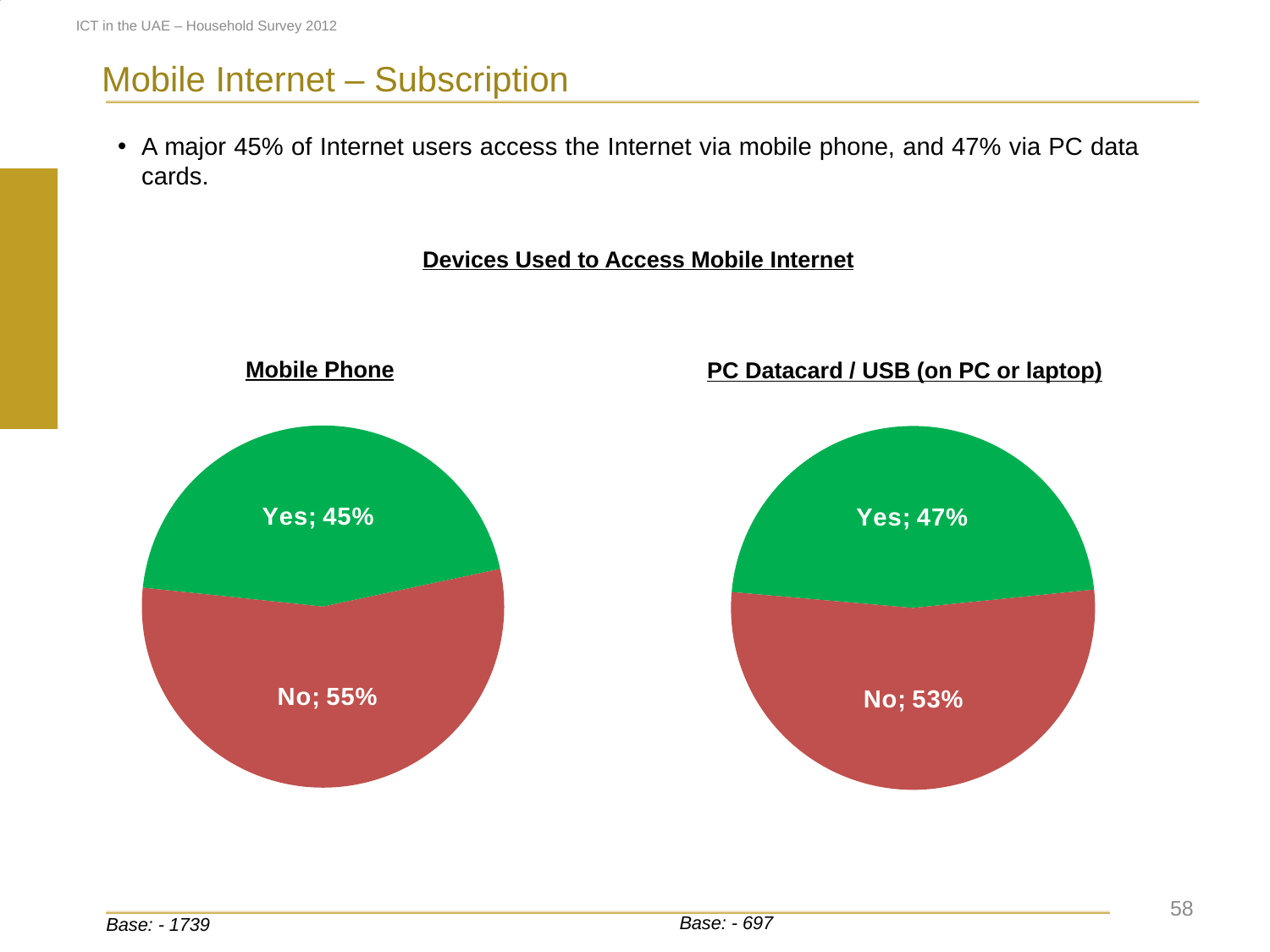
In the Mobile Phone pie chart, what percentage answered Yes? 45% In the PC Datacard / USB (on PC or laptop) pie chart, what is the difference between the No and Yes shares? 6% In the Mobile Phone pie chart, what is the difference between the No and Yes shares? 10% In the PC Datacard / USB (on PC or laptop) pie chart, which slice is the smallest? Yes What type of chart is used for the Mobile Phone data? Pie chart Which chart has the larger Yes share, Mobile Phone or PC Datacard / USB (on PC or laptop)? PC Datacard / USB (on PC or laptop) In the Mobile Phone pie chart, what percentage answered No? 55% How many slices does the PC Datacard / USB (on PC or laptop) pie chart have? 2 In the Mobile Phone pie chart, which slice is larger, Yes or No? No In the PC Datacard / USB (on PC or laptop) pie chart, what percentage answered Yes? 47% What colour is the Yes slice in the Mobile Phone pie chart? Green In the PC Datacard / USB (on PC or laptop) pie chart, what percentage answered No? 53%